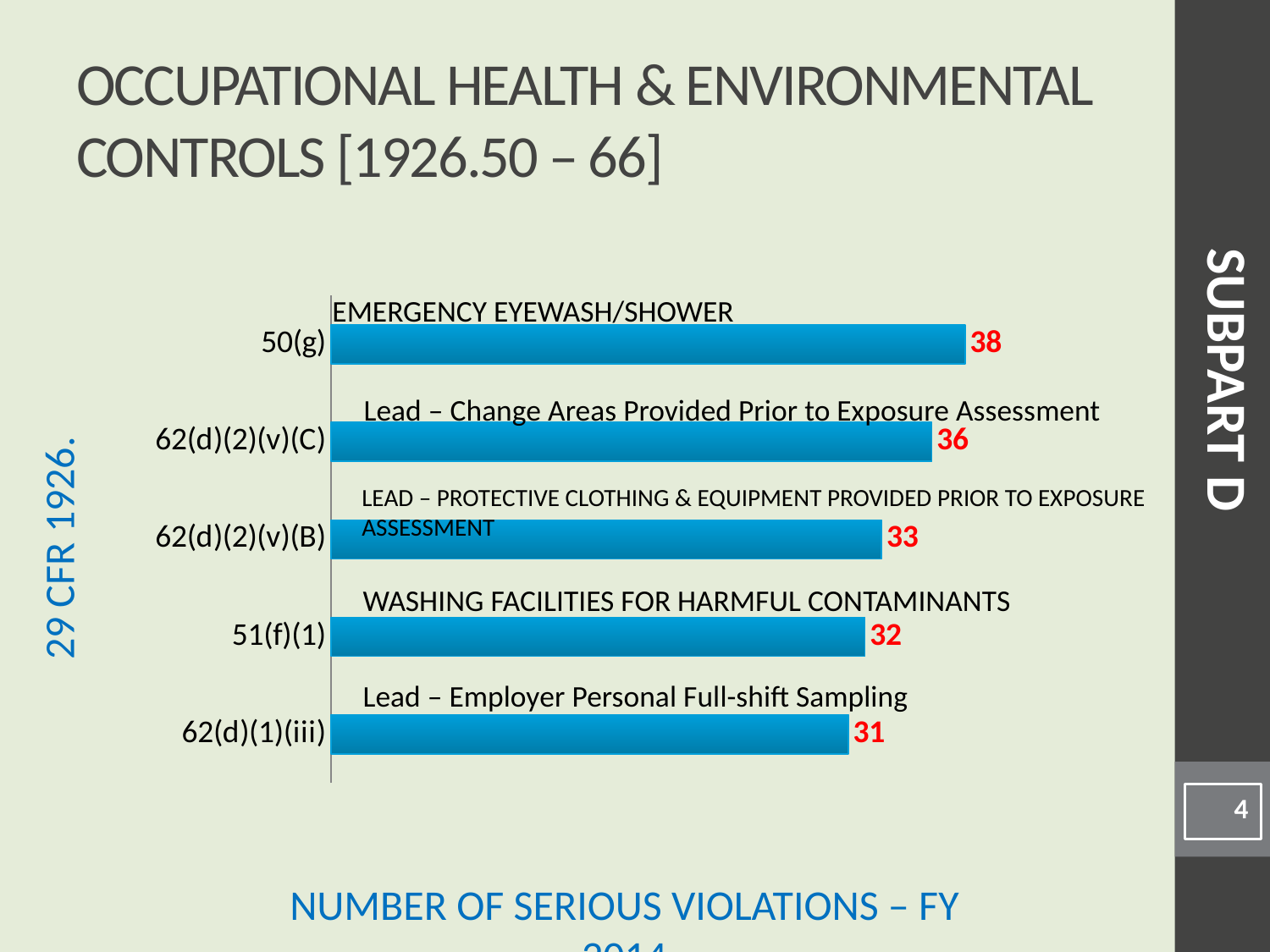
What is the description shown above the bar for 50(g)? EMERGENCY EYEWASH/SHOWER Which category has the lowest number of serious violations? 62(d)(1)(iii) What kind of chart is shown on the slide? bar chart What is the number of serious violations for 62(d)(2)(v)(C)? 36 How many categories are shown in the chart? 5 Which has a larger value, 51(f)(1) or 62(d)(2)(v)(B)? 62(d)(2)(v)(B) What is the difference between the values for 62(d)(2)(v)(C) and 62(d)(2)(v)(B)? 3 What is the number of serious violations for 62(d)(1)(iii)? 31 Which category has the highest number of serious violations? 50(g) What is the difference between the values for 50(g) and 62(d)(1)(iii)? 7 What is the number of serious violations for 50(g)? 38 What is the number of serious violations for 51(f)(1)? 32